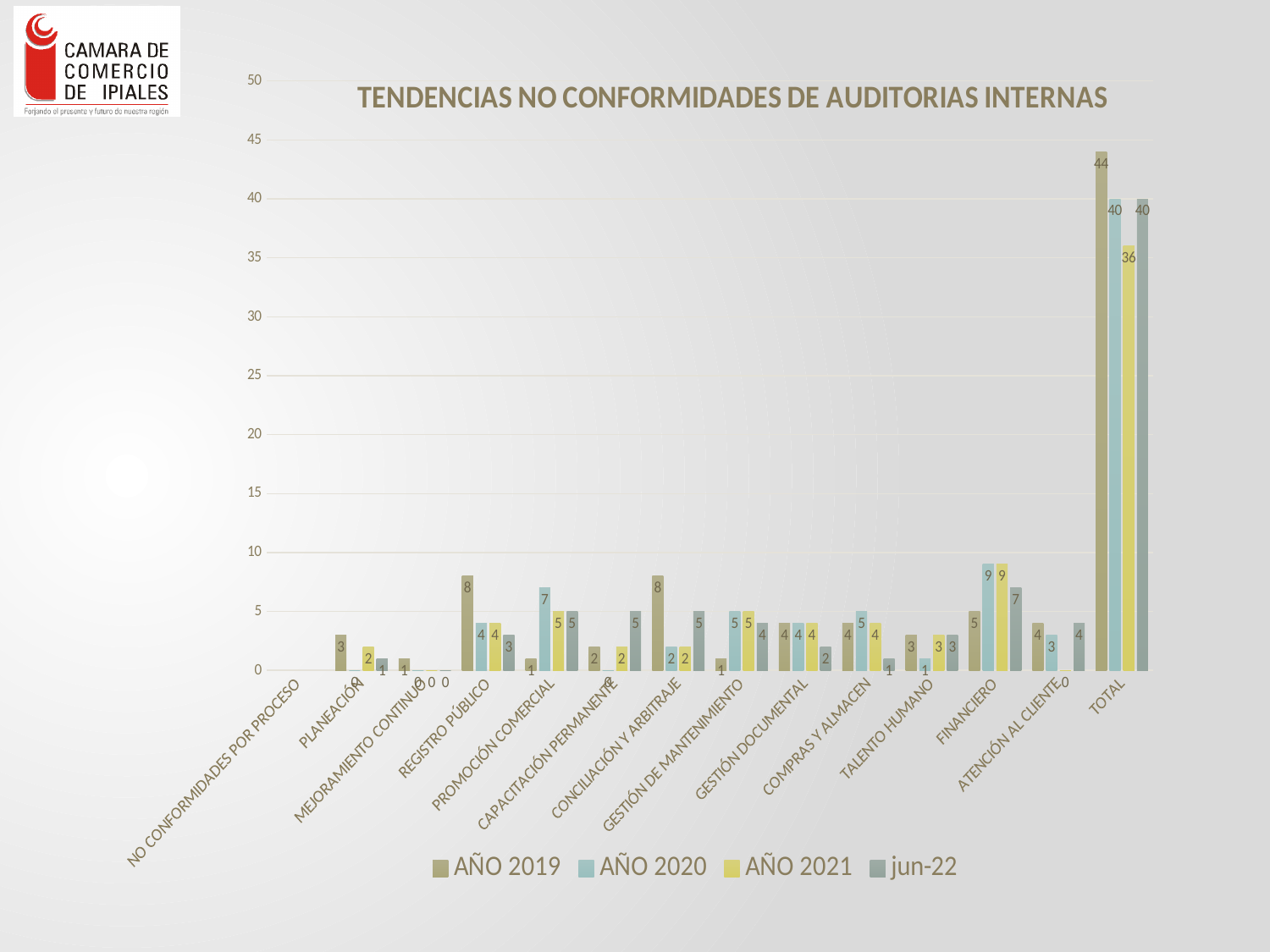
What is the TOTAL value for AÑO 2019? 44 Is the TOTAL value for AÑO 2019 greater or less than 40? greater What is the value for REGISTRO PÚBLICO in AÑO 2019? 8 What is the value for FINANCIERO in AÑO 2020? 9 What is the value for PROMOCIÓN COMERCIAL in AÑO 2020? 7 What is the title of the chart? TENDENCIAS NO CONFORMIDADES DE AUDITORIAS INTERNAS What type of chart is shown on the slide? bar chart Which is larger for CONCILIACIÓN Y ARBITRAJE: the AÑO 2019 value or the jun-22 value? AÑO 2019 Which series has the highest TOTAL value? AÑO 2019 What is the TOTAL value for AÑO 2021? 36 How many series does the legend list? 4 What is the difference between the TOTAL for AÑO 2019 and the TOTAL for AÑO 2021? 8